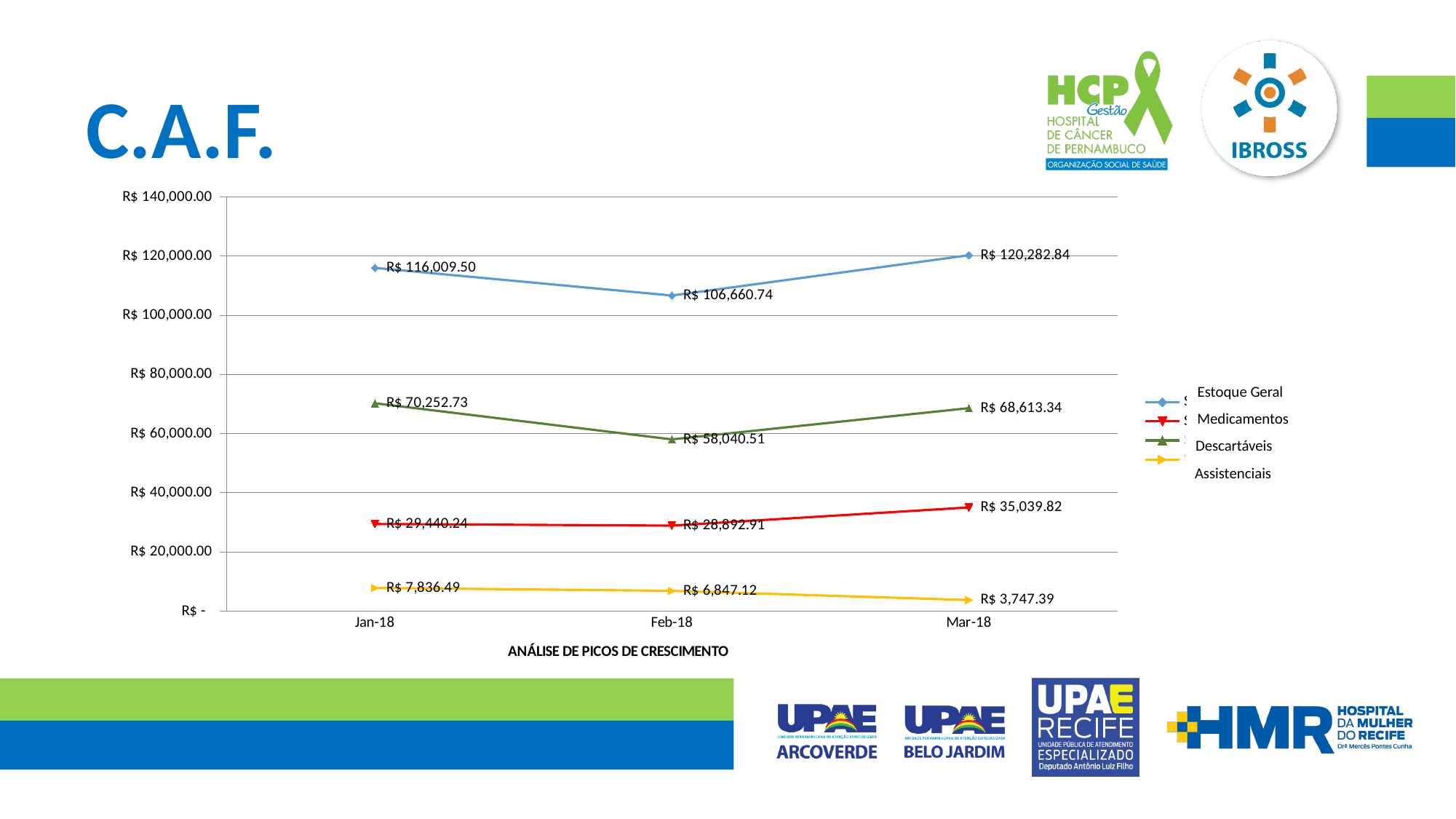
What kind of chart is shown on the slide? line chart What is the difference between Estoque Geral in Mar-18 and Jan-18? R$ 4,273.34 In which month is Estoque Geral highest? Mar-18 What is the value of Descartáveis in Jan-18? R$ 70,252.73 Do the Assistenciais values rise or fall from Jan-18 to Mar-18? fall What is the value of Medicamentos in Mar-18? R$ 35,039.82 What is the value of Estoque Geral in Feb-18? R$ 106,660.74 How many series does the legend list? 4 Which is larger: Medicamentos in Jan-18 or Medicamentos in Feb-18? Jan-18 What is the value of Assistenciais in Feb-18? R$ 6,847.12 How many months are plotted along the x axis? 3 In which month is Assistenciais lowest? Mar-18